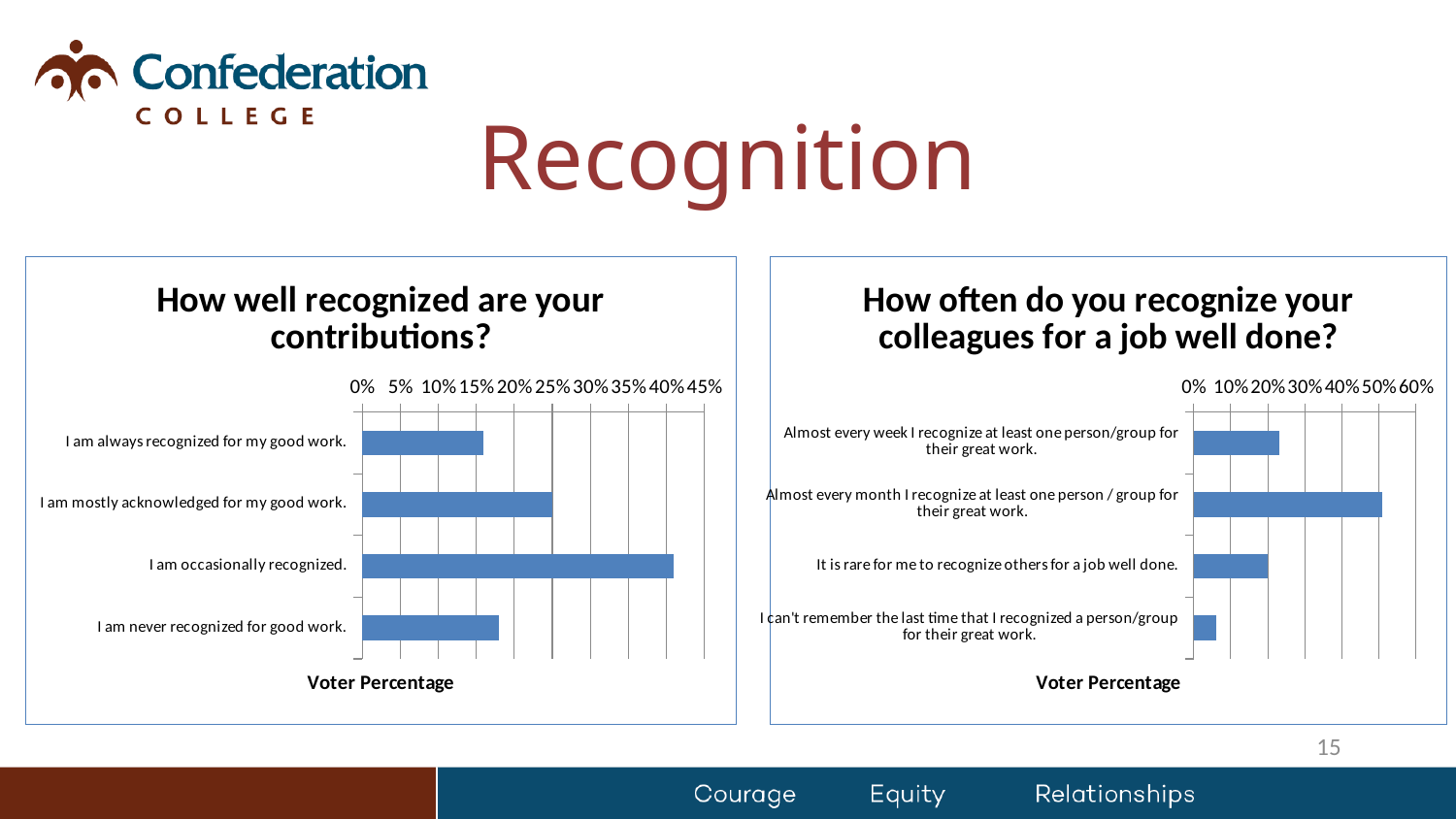
On the chart titled "How often do you recognize your colleagues for a job well done?", which is larger: the value for "Almost every week I recognize at least one person/group for their great work." or the value for "I can't remember the last time that I recognized a person/group for their great work."? Almost every week I recognize at least one person/group for their great work. On the chart titled "How well recognized are your contributions?", is the value for "I am always recognized for my good work." greater or less than 20%? less On the chart titled "How often do you recognize your colleagues for a job well done?", which category has the lowest voter percentage? I can't remember the last time that I recognized a person/group for their great work. On the chart titled "How often do you recognize your colleagues for a job well done?", is the value for "I can't remember the last time that I recognized a person/group for their great work." greater or less than 10%? less On the chart titled "How well recognized are your contributions?", which is larger: the value for "I am occasionally recognized." or the value for "I am mostly acknowledged for my good work."? I am occasionally recognized. On the chart titled "How often do you recognize your colleagues for a job well done?", which category has the highest voter percentage? Almost every month I recognize at least one person / group for their great work. On the chart titled "How well recognized are your contributions?", is the value for "I am occasionally recognized." greater or less than 35%? greater On the chart titled "How well recognized are your contributions?", which category has the highest voter percentage? I am occasionally recognized. What is the axis title shown below the bars on the chart titled "How well recognized are your contributions?"? Voter Percentage How many categories are shown on the chart titled "How well recognized are your contributions?"? 4 What kind of chart is the chart titled "How often do you recognize your colleagues for a job well done?"? bar chart